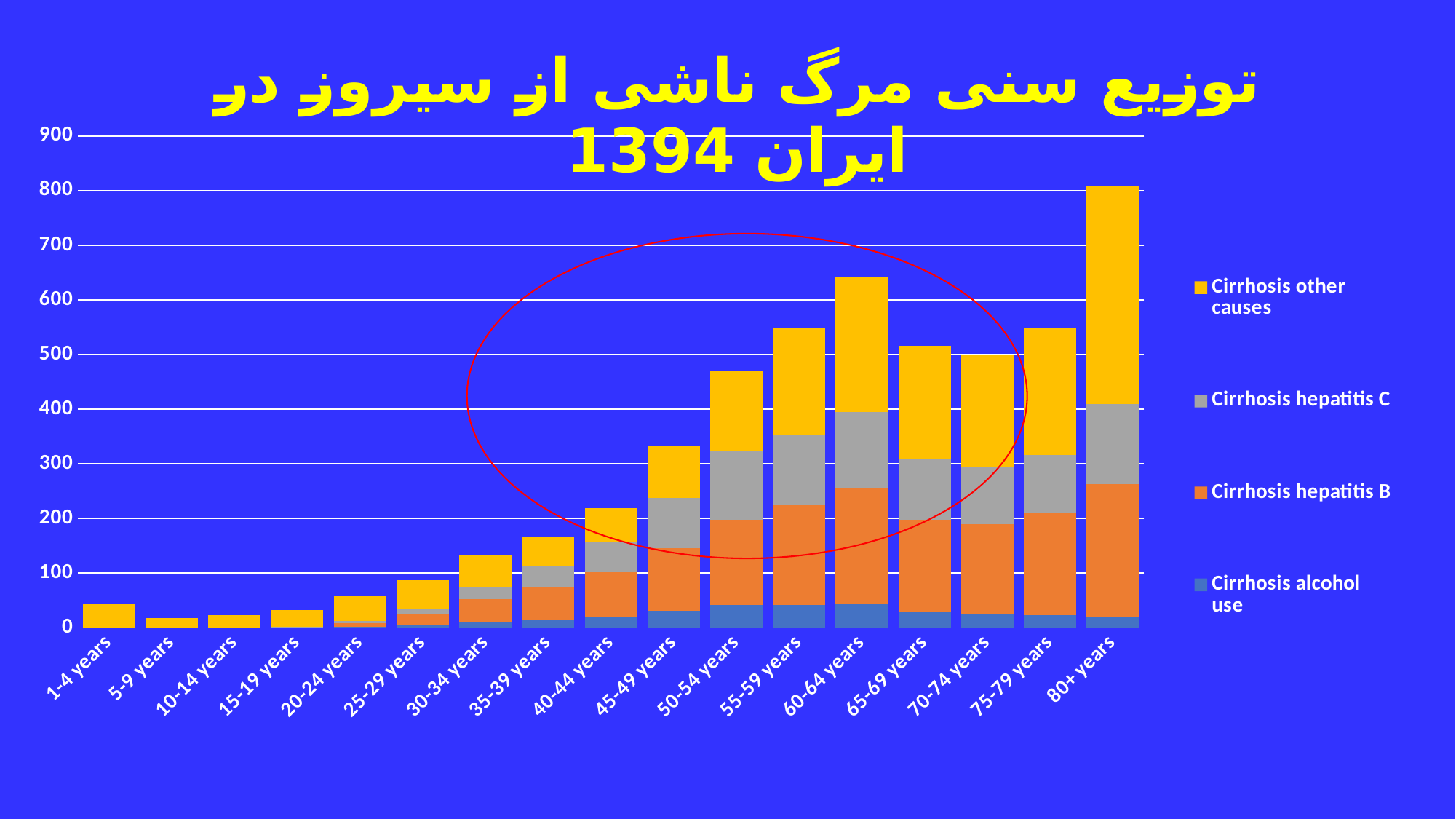
Which age group has the tallest stacked bar? 80+ years Is the total for 50-54 years greater or less than 400? greater Is the total for 1-4 years greater or less than 100? less Which has the larger total, 60-64 years or 55-59 years? 60-64 years Do the bar totals generally rise or fall from 1-4 years to 60-64 years? rise Which age group has the shortest stacked bar? 5-9 years Which legend entry is shown in yellow? Cirrhosis other causes How many series does the legend list? 4 What kind of chart is shown on the slide? Stacked bar chart How many age-group categories are shown on the x axis? 17 Is the total for 60-64 years greater or less than 600? greater